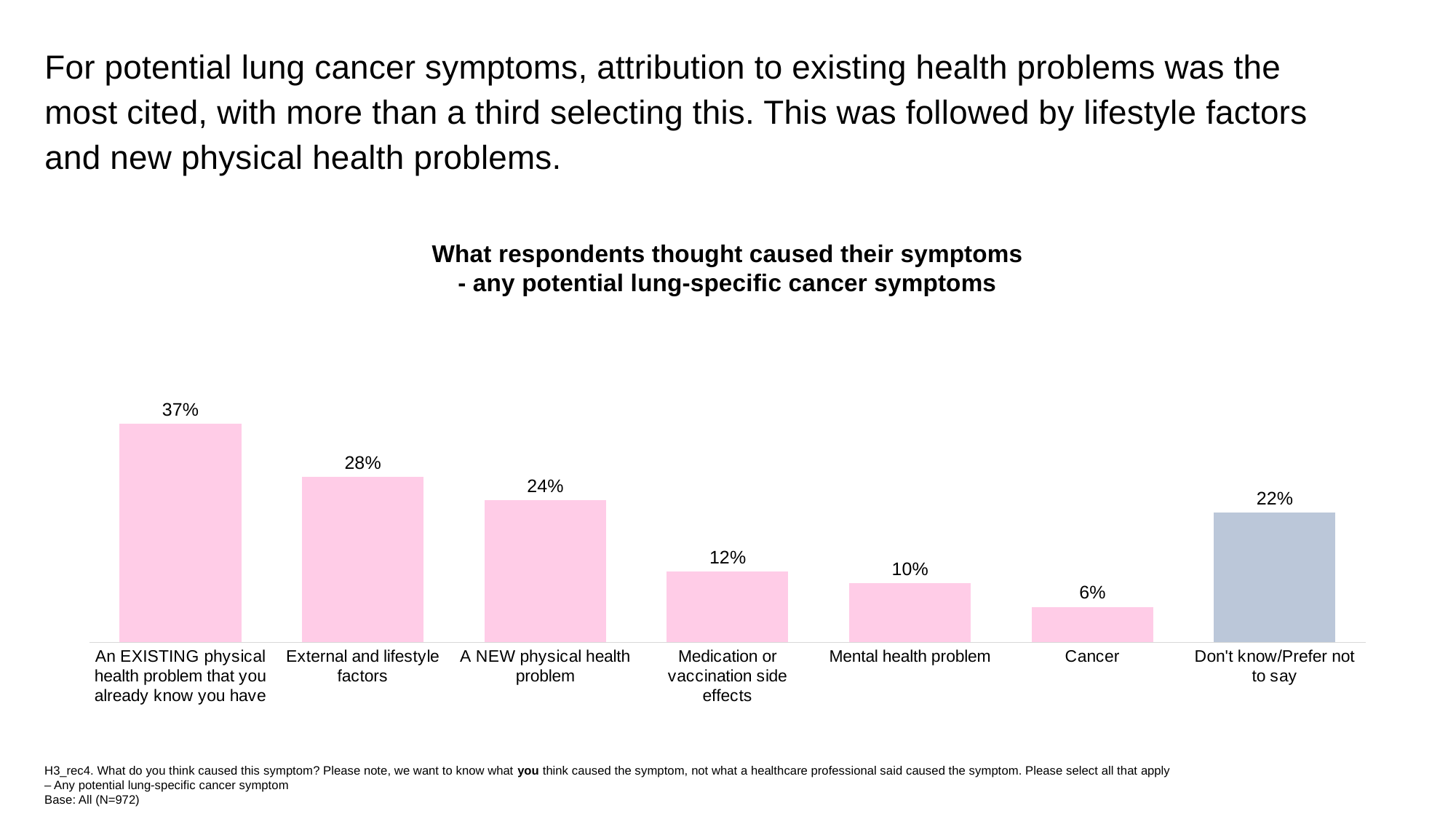
What is the difference between the values for 'A NEW physical health problem' and 'Mental health problem'? 14 percentage points What is the value shown for 'External and lifestyle factors'? 28% Which category has the lowest value in the chart? Cancer Which is larger: the value for 'Cancer' or the value for 'Mental health problem'? Mental health problem What percentage of respondents thought medication or vaccination side effects caused their symptoms? 12% What is the title of the chart? What respondents thought caused their symptoms - any potential lung-specific cancer symptoms Which category has the highest value in the chart? An EXISTING physical health problem that you already know you have What is the value for 'Don't know/Prefer not to say'? 22% How many categories are shown in the chart? 7 Which bar is coloured differently (grey-blue) from the other pink bars? Don't know/Prefer not to say What percentage of respondents attributed their symptoms to an existing physical health problem that they already know they have? 37% What type of chart is shown on the slide? Bar chart